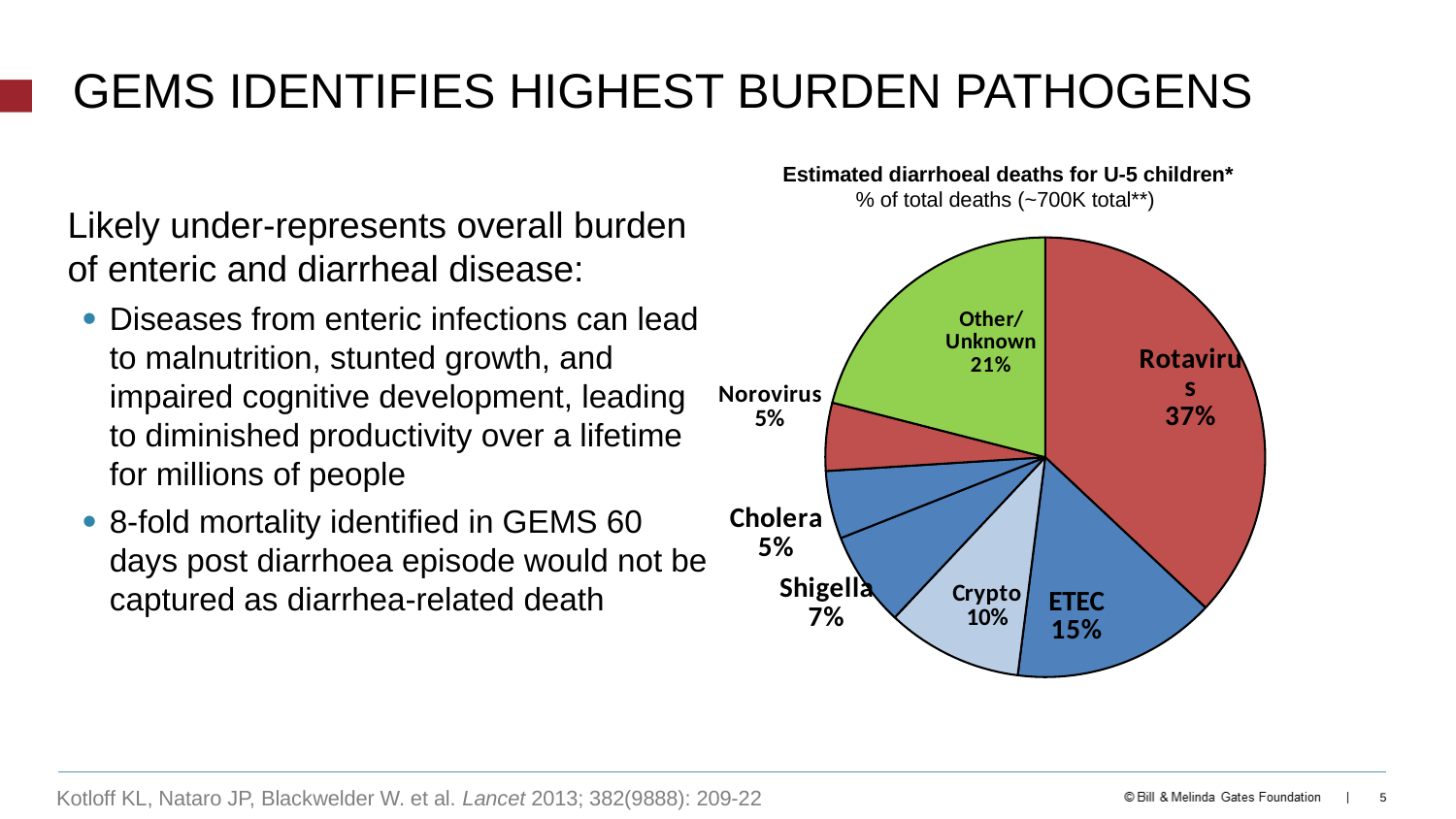
What percentage of total deaths does the ETEC slice represent? 15% Which two categories share the smallest percentage in the pie chart? Cholera and Norovirus What is the value shown for Crypto in the pie chart? 10% What percentage is shown for Shigella? 7% What is the title of the chart? Estimated diarrhoeal deaths for U-5 children* What is the difference in percentage points between Rotavirus and ETEC? 22 Which pathogen accounts for the largest share of estimated diarrhoeal deaths? Rotavirus Which is larger, the share for Other/Unknown or the share for ETEC? Other/Unknown What is the combined percentage of Cholera and Norovirus? 10% How many slices does the pie chart have? 7 What type of chart is shown on the slide? Pie chart What share of estimated diarrhoeal deaths for U-5 children is attributed to Rotavirus? 37%